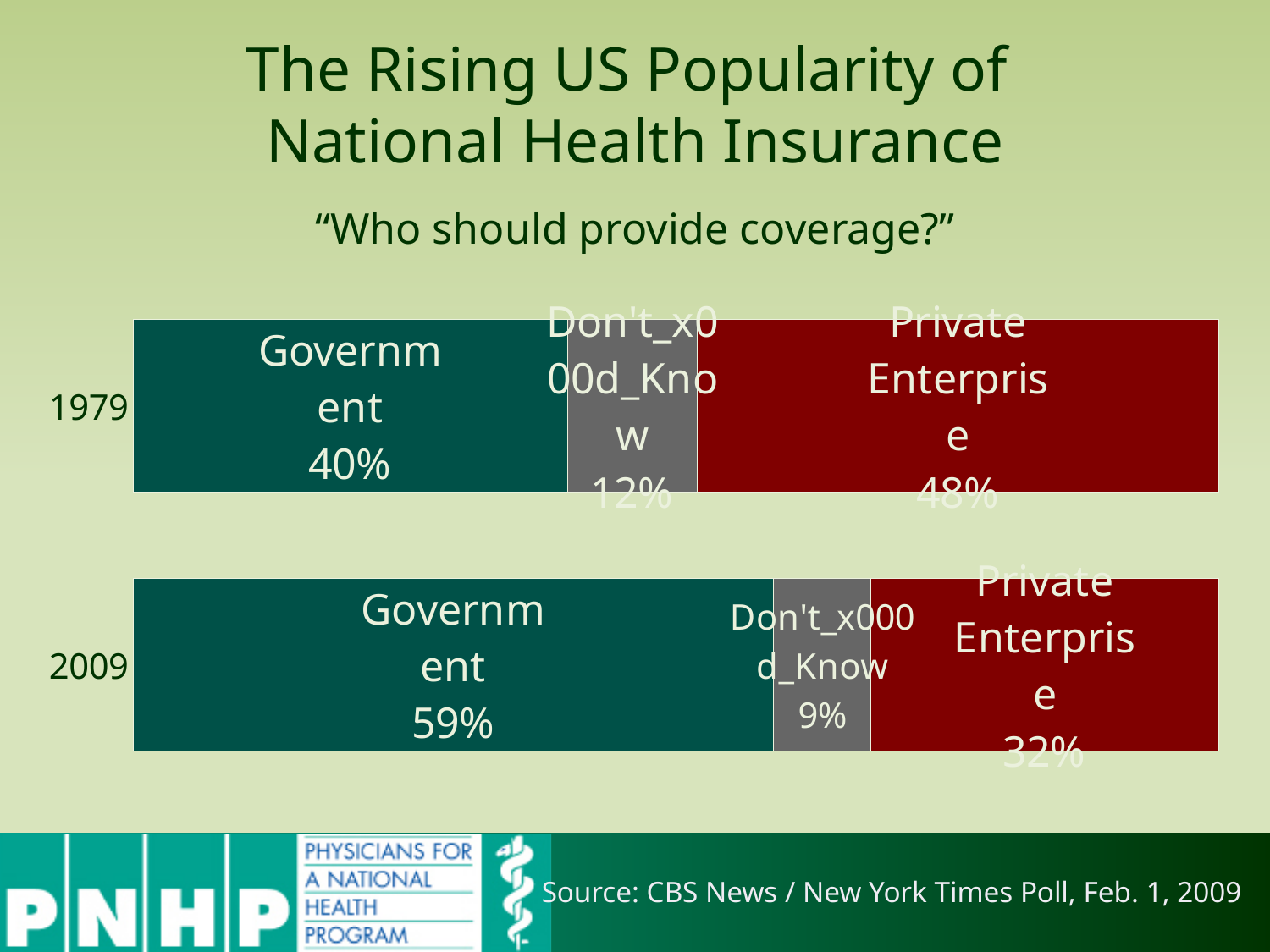
What percentage chose Government in 2009? 59% By how many percentage points did the Government share increase from 1979 to 2009? 19 How many years (bars) are shown in the chart? 2 What type of chart is shown on the slide? Stacked bar chart What is the total of the three segments in the 1979 bar? 100% What percentage answered Don't Know in 2009? 9% Which response had the smallest share in 2009? Don't Know Which was larger in 2009, the Government share or the Private Enterprise share? Government Which response had the largest share in 1979? Private Enterprise What percentage chose Private Enterprise in 2009? 32% What percentage chose Government in 1979? 40% What percentage chose Private Enterprise in 1979? 48%